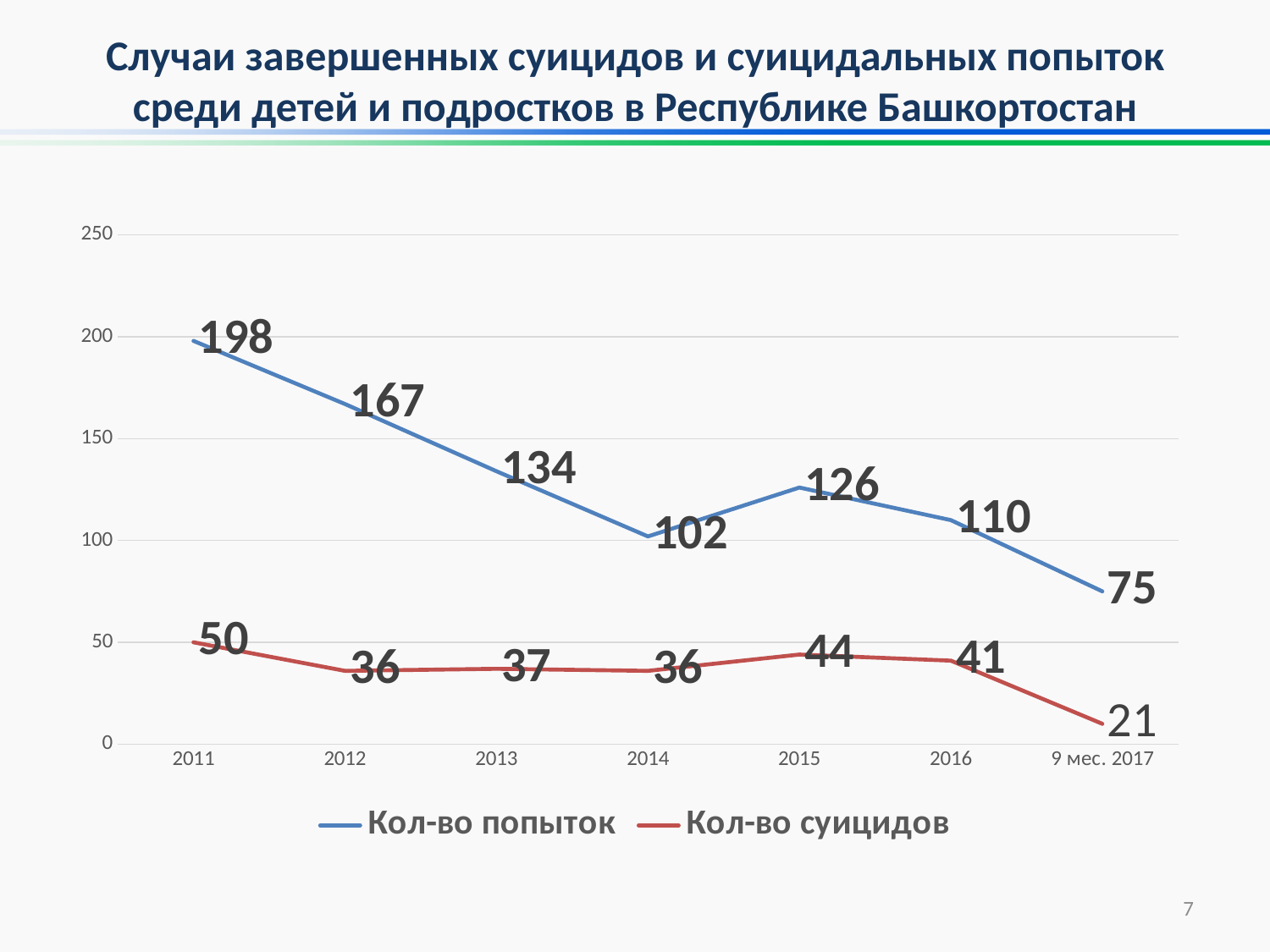
How many time periods are shown on the x axis? 7 What kind of chart is shown on the slide? line chart What is the value of Кол-во попыток in 2011? 198 What is the value of Кол-во попыток for 9 мес. 2017? 75 What is the value of Кол-во суицидов in 2015? 44 How many series does the legend list? 2 Does Кол-во попыток generally rise or fall from 2011 to 9 мес. 2017? fall What is the difference between Кол-во попыток and Кол-во суицидов in 2014? 66 In which year is Кол-во попыток highest? 2011 Which is larger: Кол-во попыток in 2015 or in 2016? 2015 In which period is Кол-во суицидов lowest? 9 мес. 2017 What is the difference between Кол-во попыток in 2011 and in 2012? 31